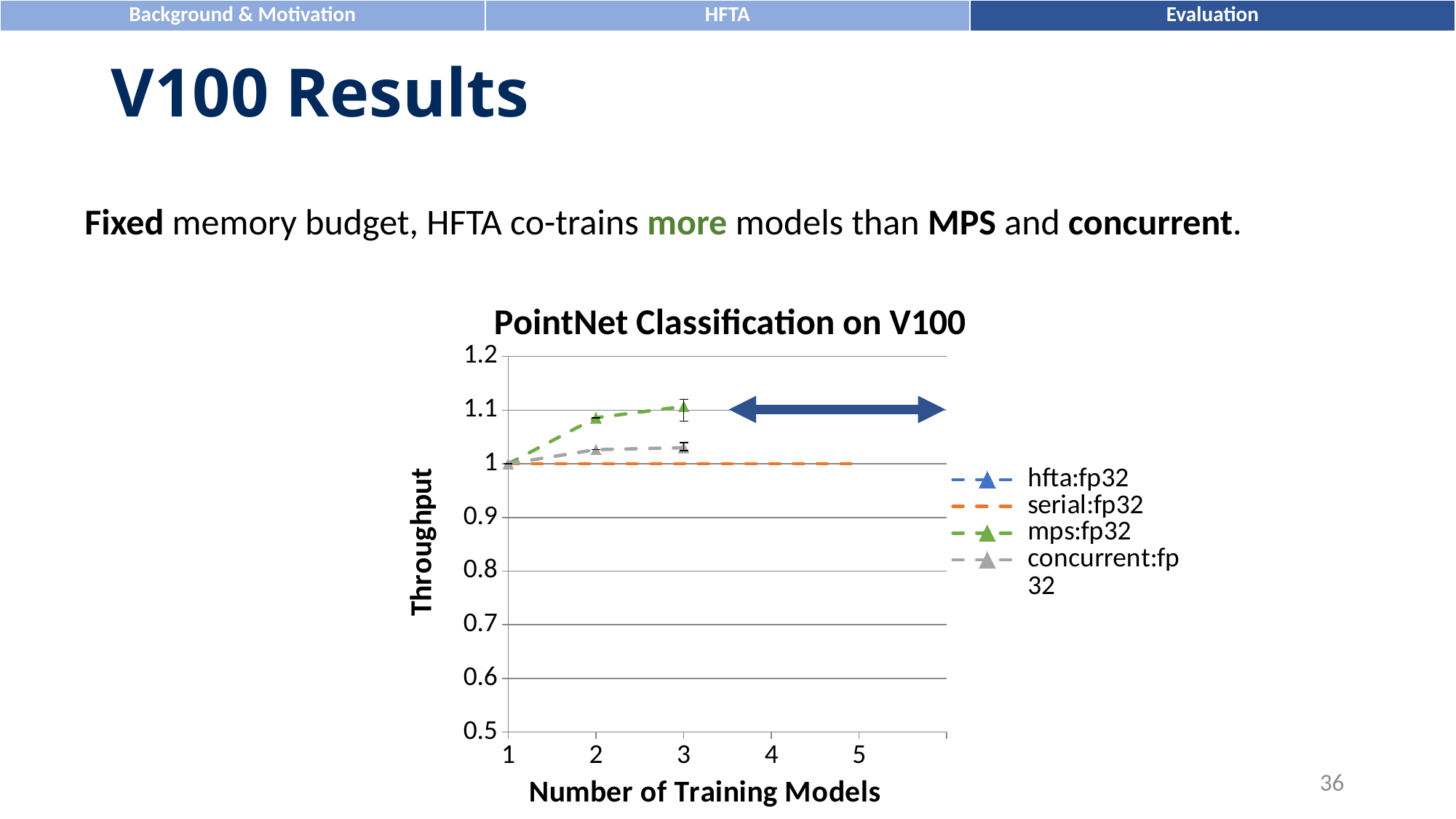
What is the title of the chart? PointNet Classification on V100 Is the throughput of mps:fp32 at 2 training models greater or less than 1.1? less Is the throughput of mps:fp32 at 3 training models greater or less than 1? greater Does the throughput of serial:fp32 rise, fall, or stay flat as the number of training models increases? stay flat What kind of chart is shown on the slide? line chart Does the throughput of mps:fp32 rise or fall as the number of training models increases from 1 to 3? rise How many series does the chart's legend list? 4 At 3 training models, which series has the higher throughput, mps:fp32 or concurrent:fp32? mps:fp32 How many tick values are shown on the x axis (Number of Training Models)? 5 What is the label of the y axis? Throughput Is the throughput of concurrent:fp32 at 3 training models greater or less than 1.1? less